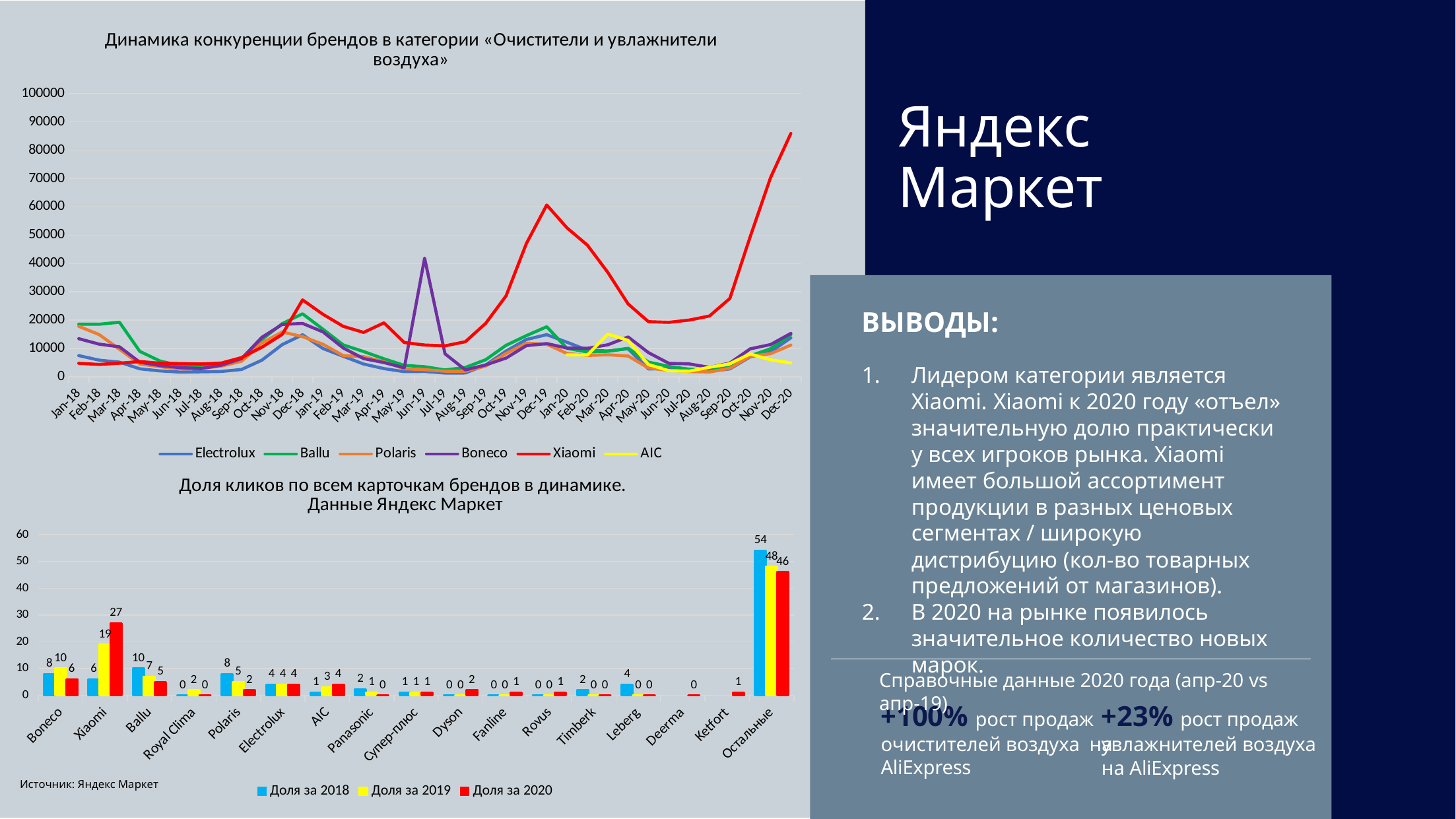
In the bottom bar chart, which is larger for Ballu: «Доля за 2018» or «Доля за 2020»? Доля за 2018 In the bottom bar chart, what is the difference between «Доля за 2020» and «Доля за 2018» for Xiaomi? 21 In the bottom bar chart, how many brand categories are shown on the x axis? 17 In the top line chart, is the value for Boneco in Jun-19 greater or less than 30000? greater In the top line chart, which brand has the highest value in Dec-20? Xiaomi In the bottom bar chart, what is the value of «Доля за 2020» for Xiaomi? 27 In the bottom bar chart, what is the value of «Доля за 2018» for Остальные? 54 In the top line chart, is the value for Xiaomi in Dec-20 greater or less than 80000? greater What kind of chart is the top chart titled «Динамика конкуренции брендов в категории «Очистители и увлажнители воздуха»»? line chart How many series does the legend of the bottom bar chart list? 3 What kind of chart is the bottom chart titled «Доля кликов по всем карточкам брендов в динамике»? bar chart How many series does the legend of the top line chart list? 6